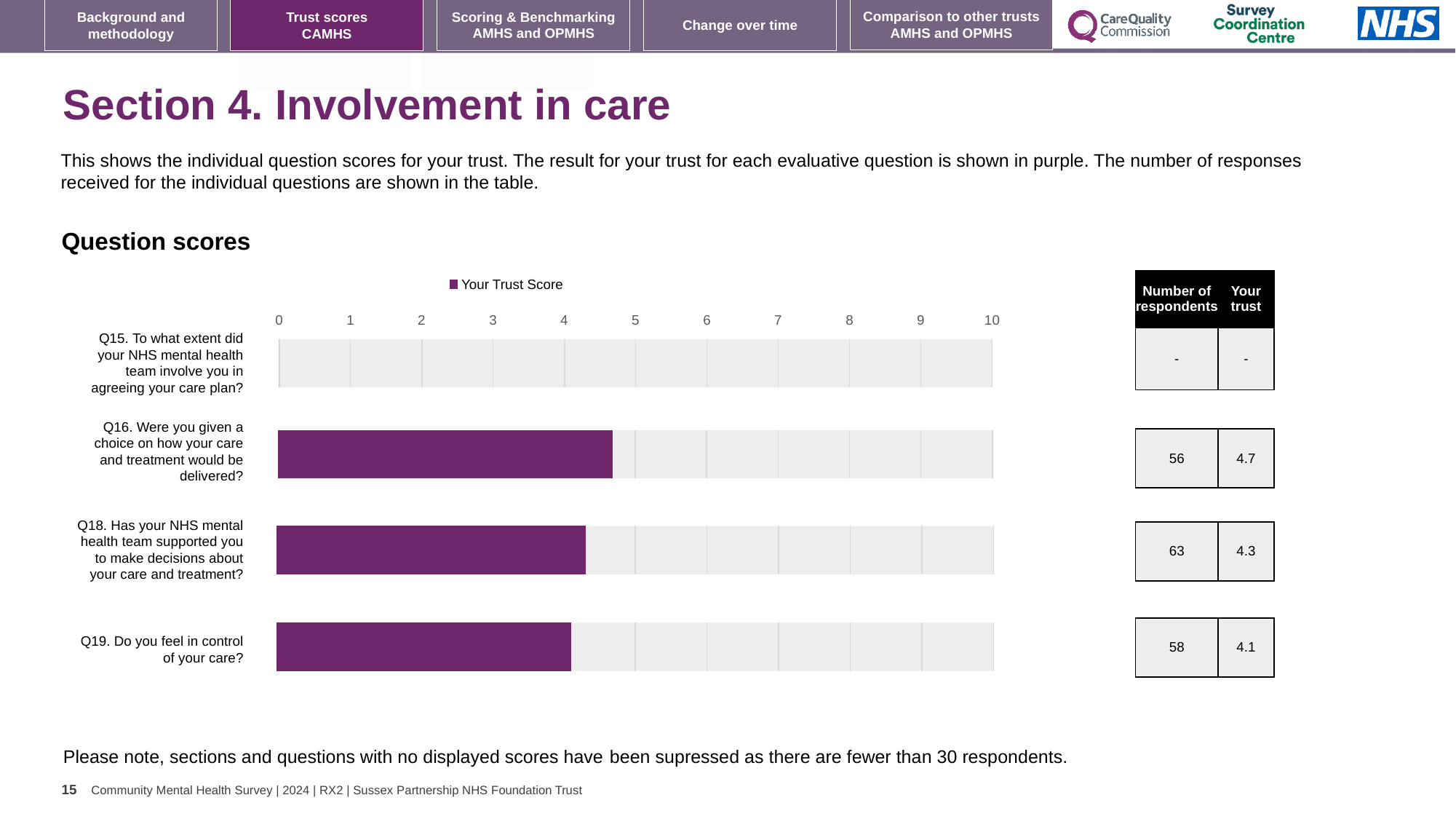
What is the trust score for Q19 (Do you feel in control of your care?)? 4.1 What is the name of the series shown in the chart legend? Your Trust Score Which has a larger trust score, Q18 or Q19? Q18 What is the difference between the trust scores for Q16 and Q19? 0.6 What is the trust score for Q18 (Has your NHS mental health team supported you to make decisions about your care and treatment?)? 4.3 What is the trust score for Q16 (Were you given a choice on how your care and treatment would be delivered?)? 4.7 Is the trust score for Q16 greater or less than 5? less Which question has the highest trust score on the chart? Q16 What kind of chart is shown under 'Question scores'? bar chart How many questions (categories) are listed on the chart's vertical axis? 4 Among the questions with a displayed score, which has the lowest trust score? Q19 How many series does the chart legend list? 1